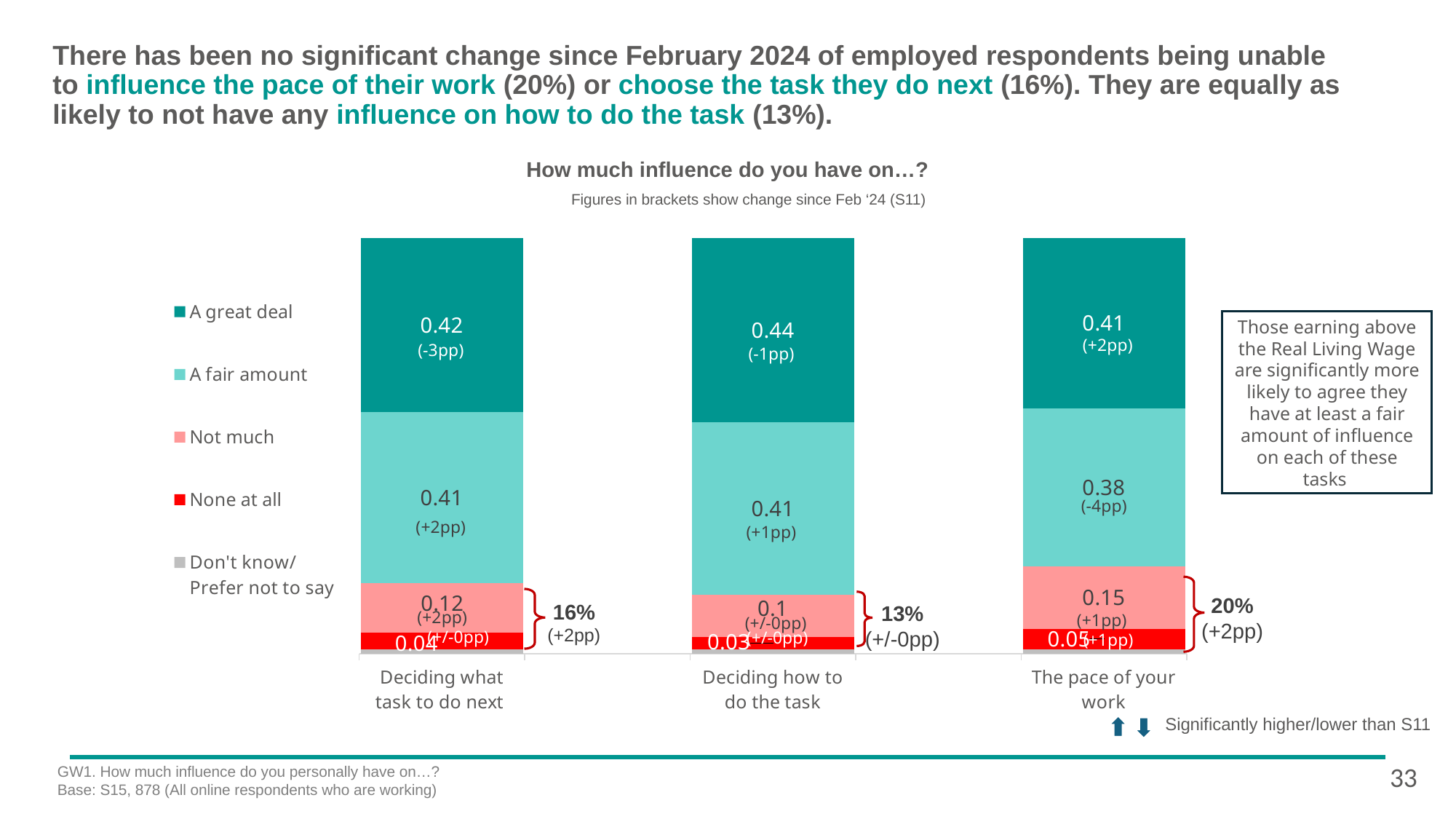
What is the value for 'Not much' for 'Deciding what task to do next'? 0.12 How many categories are shown on the x axis of the chart? 3 What is the difference between the 'Not much' values for 'The pace of your work' and 'Deciding how to do the task'? 0.05 What is the value for 'None at all' for 'The pace of your work'? 0.05 What is the value for 'A fair amount' for 'The pace of your work'? 0.38 What combined percentage is shown in the bracket next to 'The pace of your work'? 20% What kind of chart is shown on the slide? Stacked bar chart Which category has the lowest value for 'A fair amount'? The pace of your work Which has the larger 'None at all' value: 'Deciding what task to do next' or 'Deciding how to do the task'? Deciding what task to do next How many series does the legend list? 5 Which category has the highest value for 'A great deal'? Deciding how to do the task What is the value for 'A great deal' for 'Deciding how to do the task'? 0.44